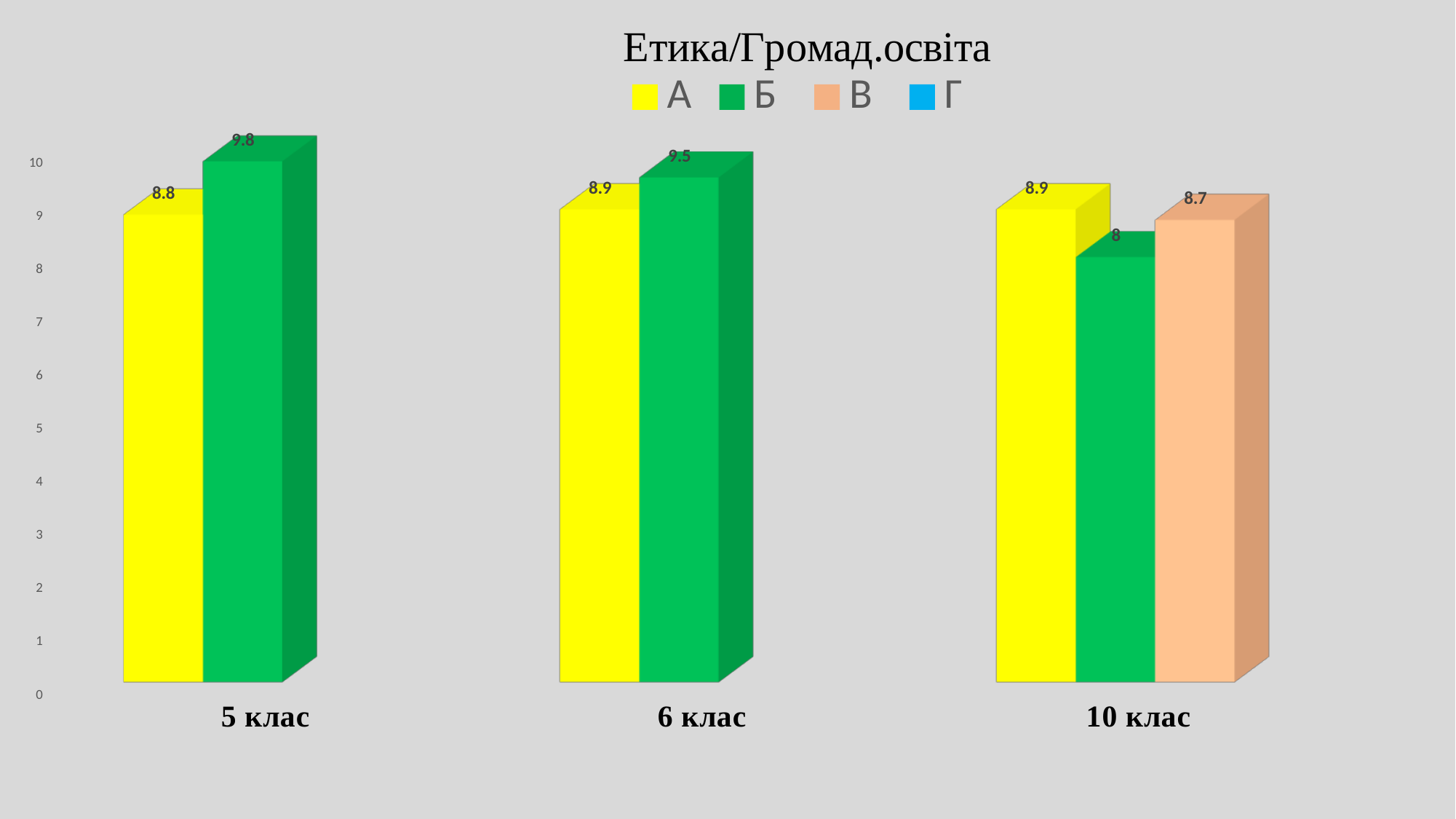
How many categories are shown on the x axis? 3 What is the value for series Б in 6 клас? 9.5 What is the difference between series Б and series А in 5 клас? 1 What is the value for series Б in 5 клас? 9.8 Which is larger in 6 клас, series А or series Б? Б Which series has the lowest value in 10 клас? Б What is the value for series Б in 10 клас? 8 What type of chart is shown? bar chart What is the value for series А in 5 клас? 8.8 How many series does the legend list? 4 What is the value for series В in 10 клас? 8.7 Which series has the highest value in 10 клас? А